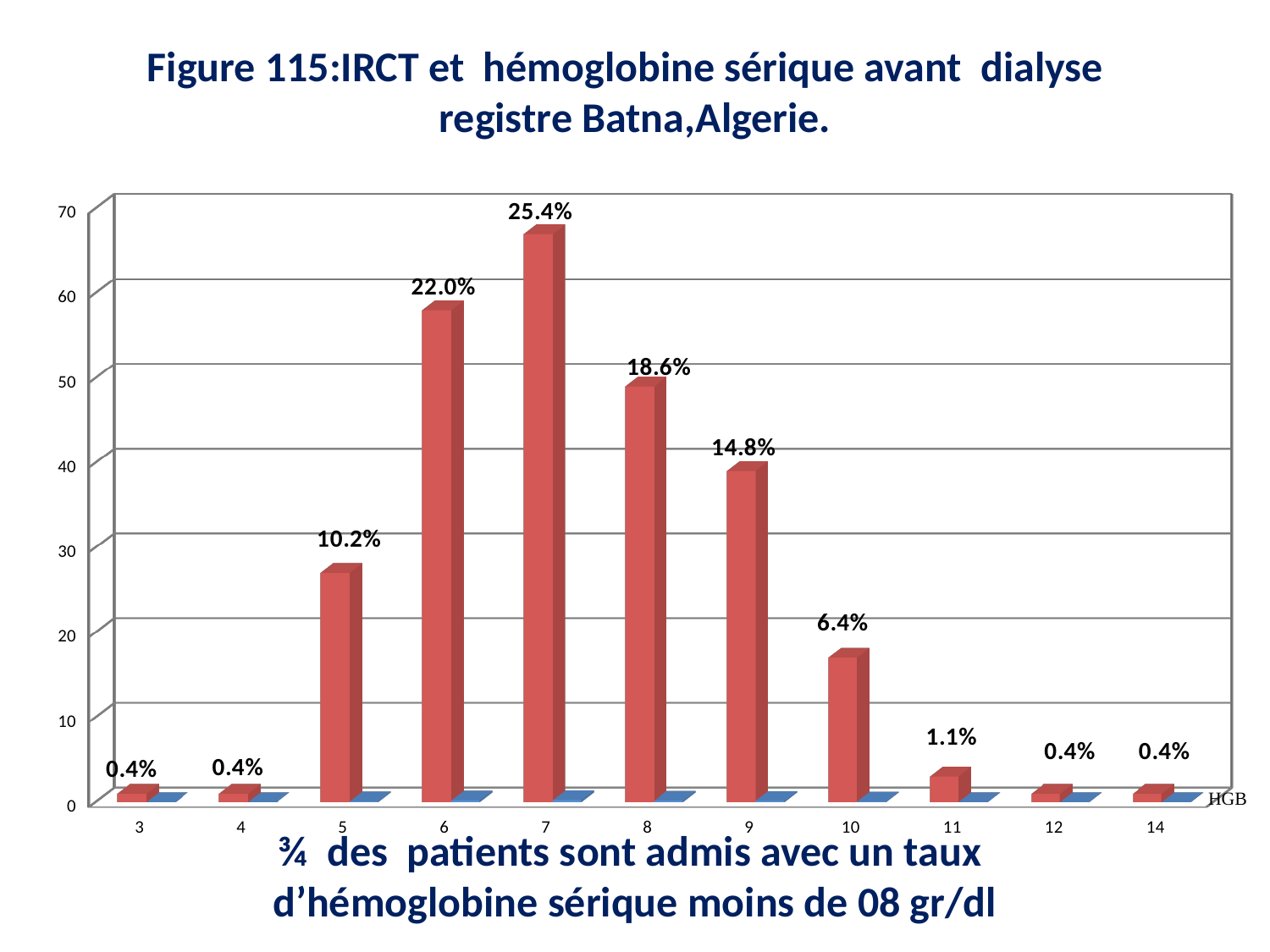
What is the data label for hemoglobin value 6? 22.0% What kind of chart is shown on the slide? bar chart What is the data label for hemoglobin value 10? 6.4% How many hemoglobin categories are shown on the x axis? 11 Is the bar for hemoglobin 10 greater or less than 20 on the vertical axis? less What is the data label for hemoglobin value 7? 25.4% Which hemoglobin category has the highest value? 7 Which has a larger value, hemoglobin 8 or hemoglobin 9? 8 What is the difference in percentage points between the labels for hemoglobin 7 and hemoglobin 6? 3.4 Is the bar for hemoglobin 7 greater or less than 60 on the vertical axis? greater What is the data label for hemoglobin value 11? 1.1% Do the values rise or fall from hemoglobin 7 to hemoglobin 11? fall